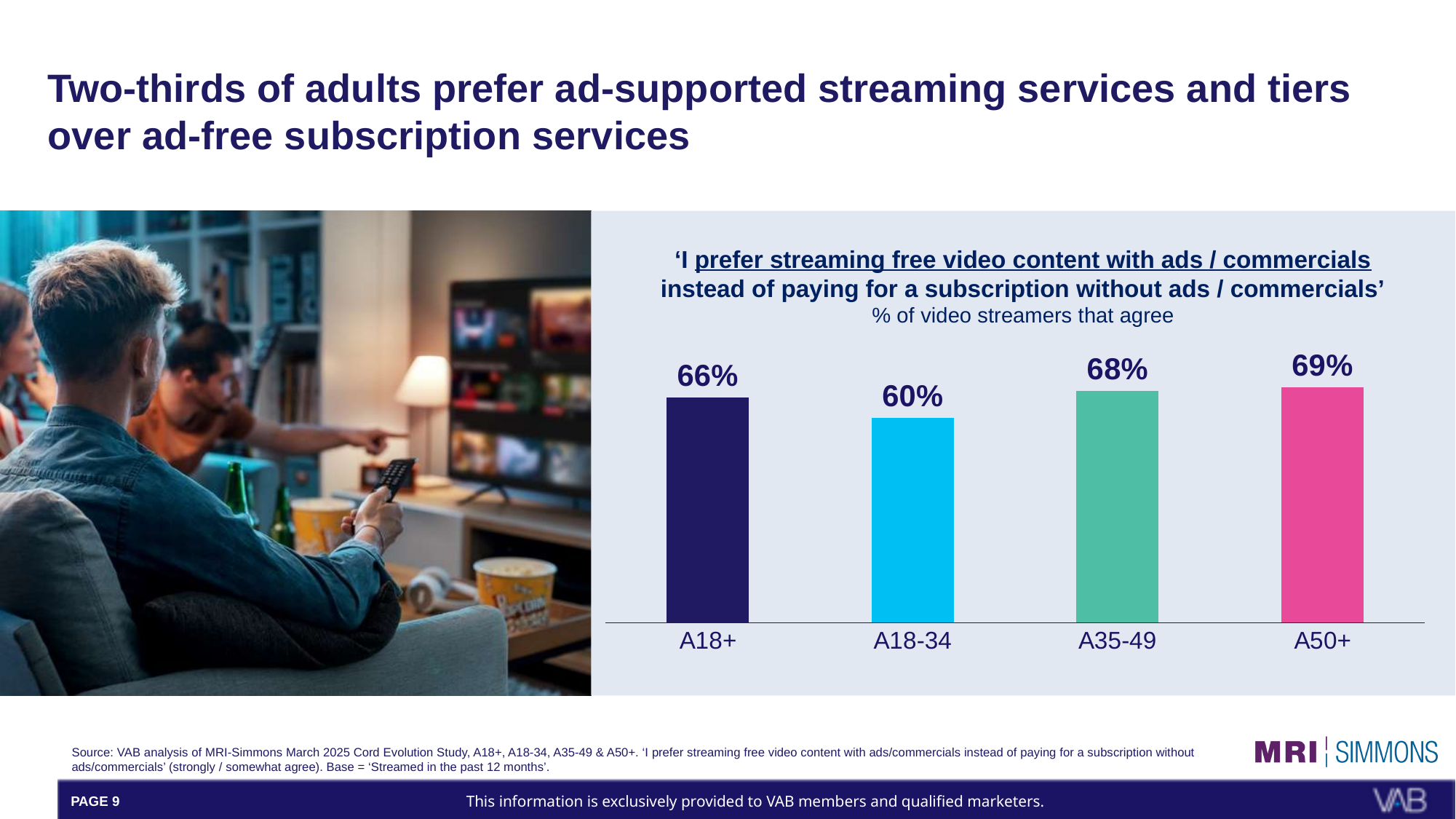
What is the value shown for A35-49? 68% What kind of chart is shown on the slide? Bar chart What is the value shown for A50+? 69% What is the difference between the A35-49 value and the A18+ value? 2 percentage points What is the difference in percentage points between A50+ and A18-34? 9 percentage points Which is larger, the value for A18-34 or the value for A35-49? A35-49 How many age groups are shown in the chart? 4 What is the value shown for A18-34? 60% What percentage of A18+ video streamers agree they prefer streaming free video content with ads instead of paying for a subscription without ads? 66% Which age group has the highest percentage agreeing? A50+ Which age group has the lowest percentage agreeing? A18-34 What colour is the bar for A50+? Pink